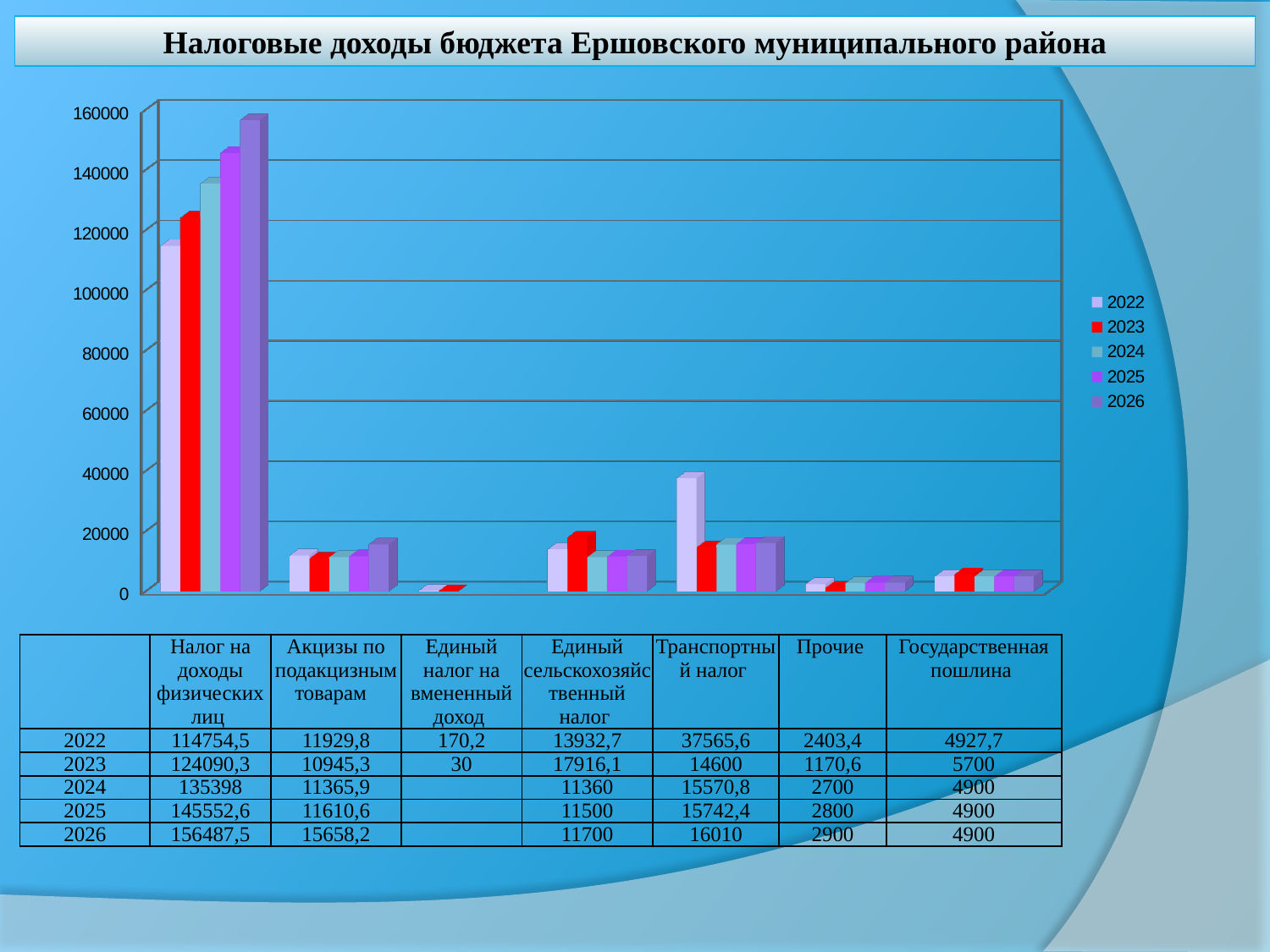
Which is larger: Транспортный налог in 2022 or Единый сельскохозяйственный налог in 2022? Транспортный налог in 2022 What is the difference between the 2026 and 2022 values of Налог на доходы физических лиц? 41733 How many tax categories are plotted on the chart? 7 What is the value of Транспортный налог for 2022? 37565,6 How many series does the legend list? 5 What is the title of the chart? Налоговые доходы бюджета Ершовского муниципального района Do the values of Налог на доходы физических лиц rise or fall from 2022 to 2026? rise Which category has the highest value in 2025? Налог на доходы физических лиц What type of chart is shown on the slide? bar chart What is the value of Единый сельскохозяйственный налог for 2023? 17916,1 Which category has the lowest value in 2023? Единый налог на вмененный доход What is the value of Налог на доходы физических лиц for 2026? 156487,5